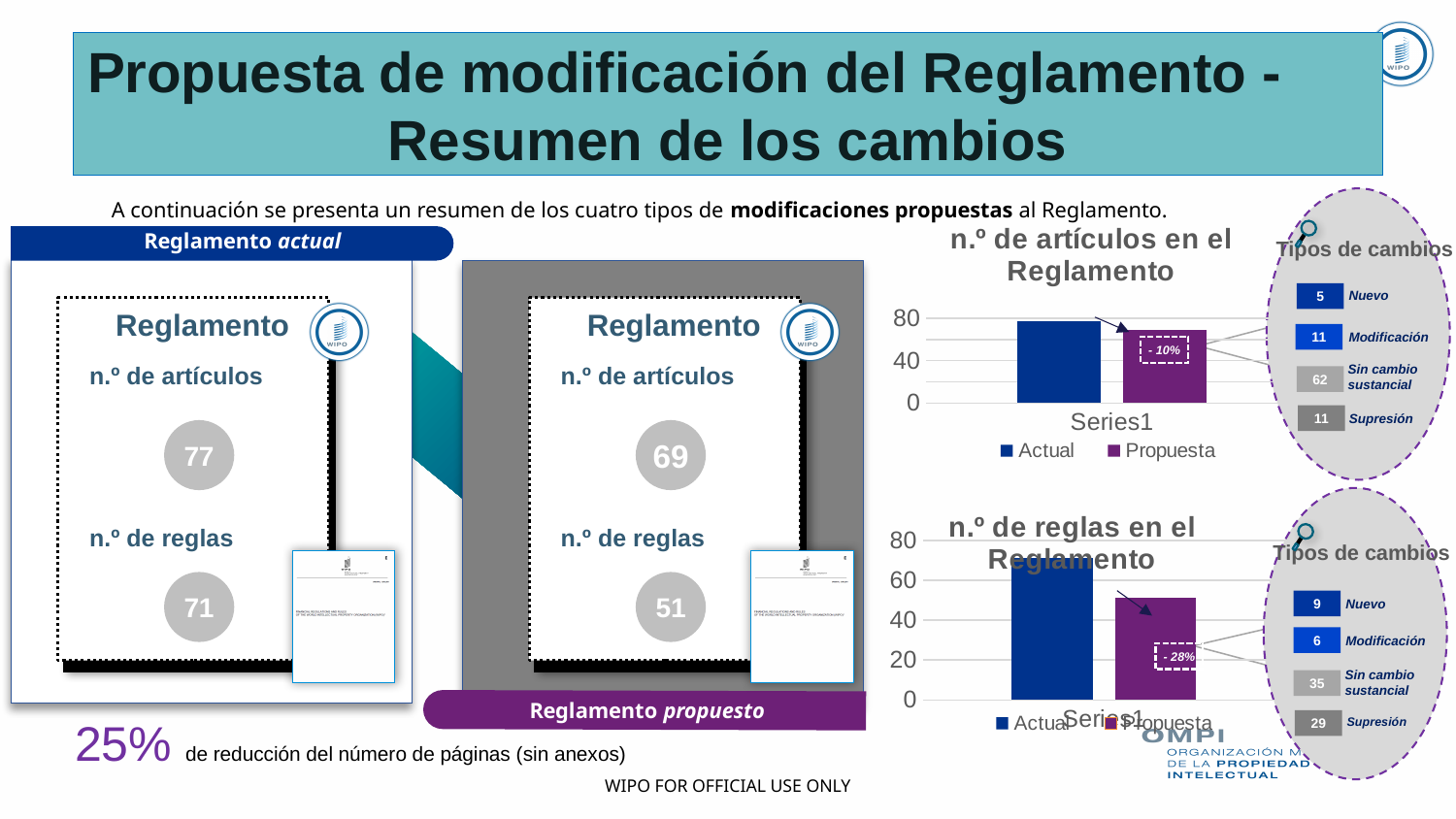
What kind of chart is "n.º de reglas en el Reglamento"? bar chart In the "n.º de reglas en el Reglamento" chart, is the value for Propuesta greater or less than 60? less How many series does the legend of the "n.º de artículos en el Reglamento" chart list? 2 In the "n.º de reglas en el Reglamento" chart, which is larger, Actual or Propuesta? Actual What are the two legend entries in the "n.º de reglas en el Reglamento" chart? Actual and Propuesta In the "n.º de artículos en el Reglamento" chart, is the value for Propuesta greater or less than 80? less What kind of chart is "n.º de artículos en el Reglamento"? bar chart In the "n.º de reglas en el Reglamento" chart, is the value for Actual greater or less than 60? greater How many categories are shown on the x axis of the "n.º de reglas en el Reglamento" chart? 1 In the "n.º de artículos en el Reglamento" chart, which is larger, Actual or Propuesta? Actual What percentage change is annotated on the Propuesta bar in the "n.º de artículos en el Reglamento" chart? - 10%